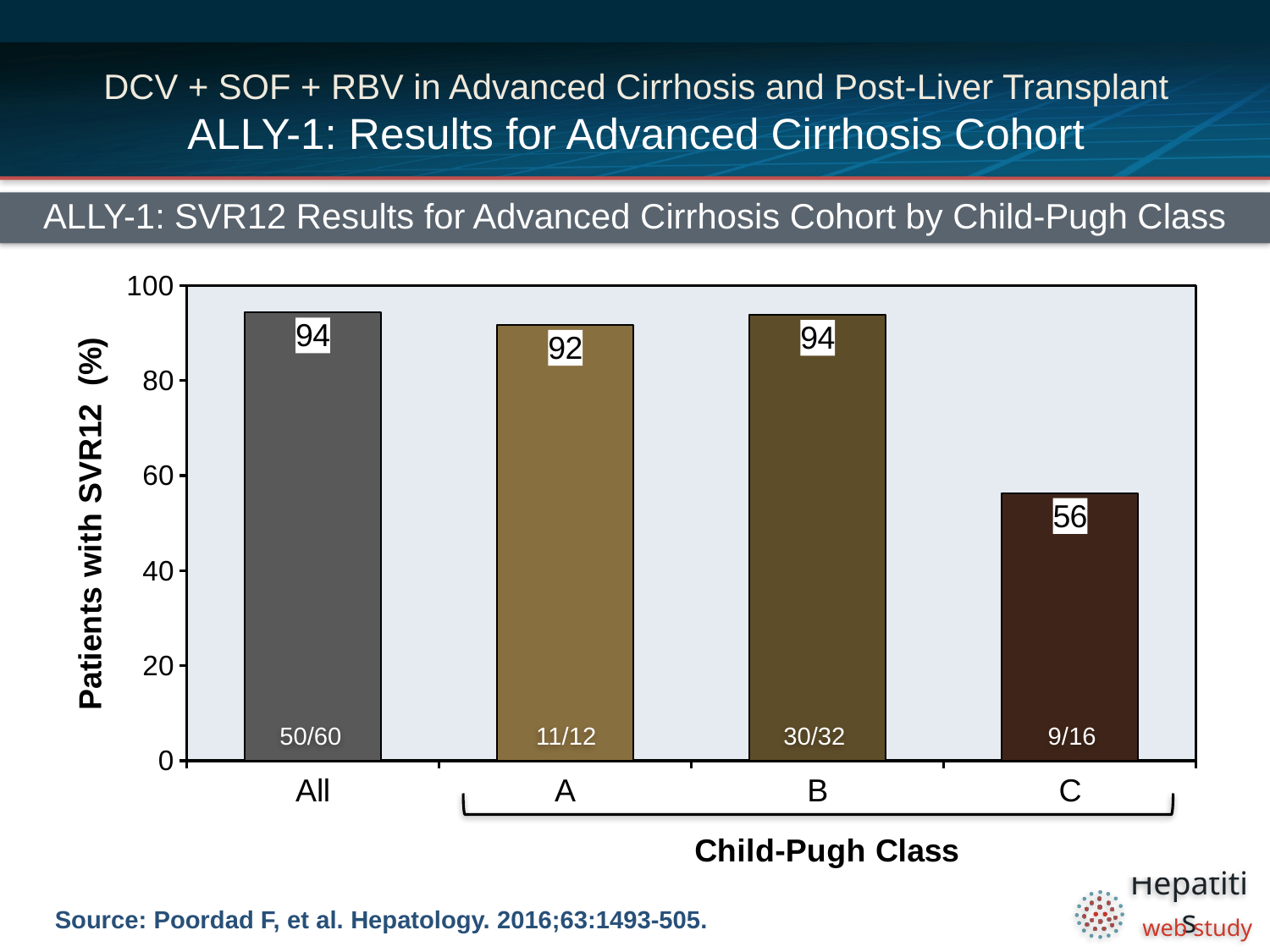
Which has a higher SVR12 rate, Child-Pugh class A or class C? A What is the SVR12 rate for Child-Pugh class A? 92 Is the value for Child-Pugh class C greater or less than 60? less How many bars are shown in the chart? 4 What is the difference in SVR12 rate between Child-Pugh class B and class C? 38 What is the label of the y axis? Patients with SVR12 (%) Which category has the lowest SVR12 rate? C What fraction of patients is shown at the base of the Child-Pugh class B bar? 30/32 What kind of chart is shown on the slide? Bar chart What is the SVR12 rate for the All group? 94 What is the difference in SVR12 rate between Child-Pugh class A and class C? 36 What is the SVR12 rate for Child-Pugh class C? 56